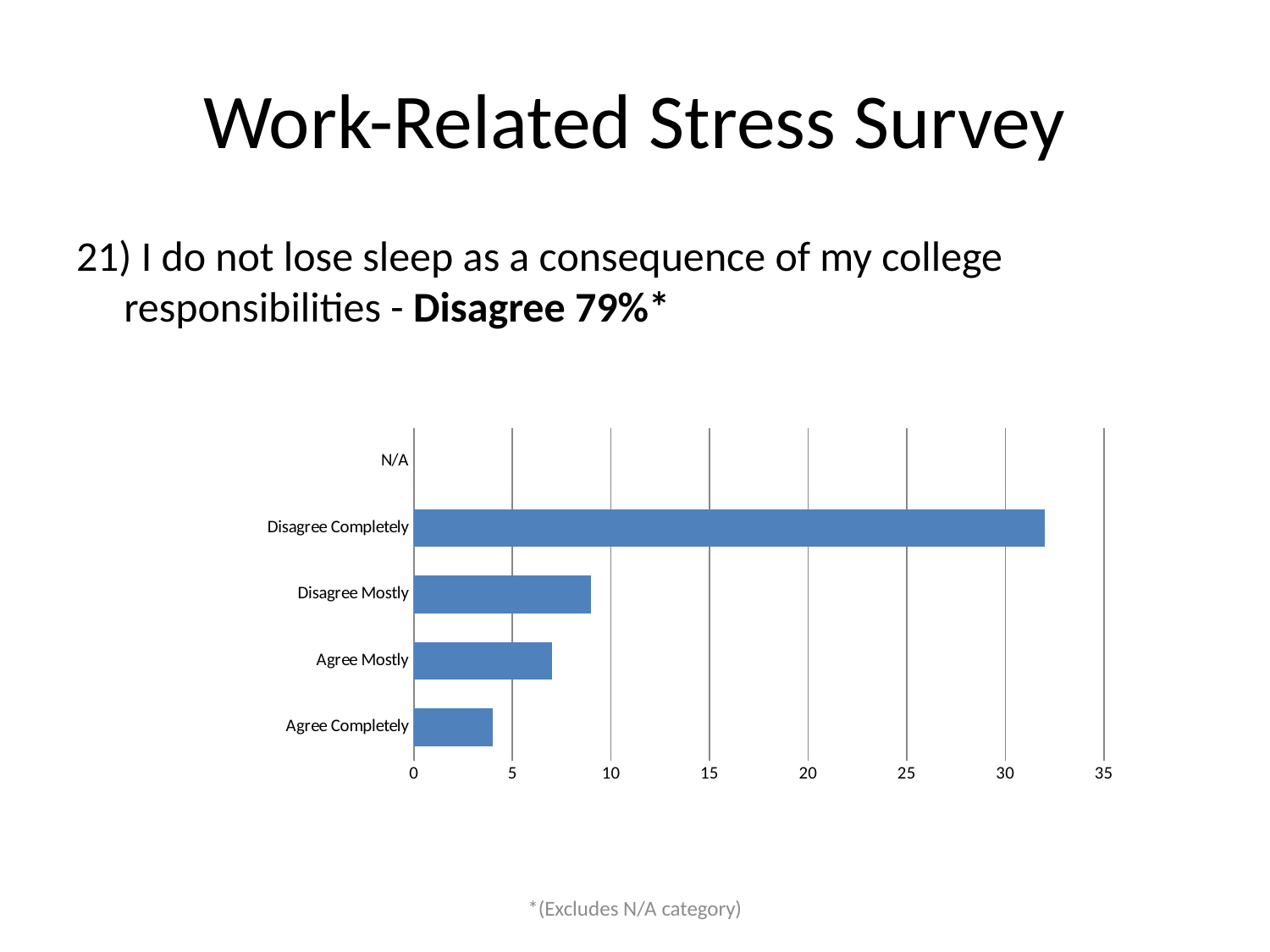
Which is larger, the value for Disagree Mostly or the value for Agree Mostly? Disagree Mostly Is the value for Disagree Mostly greater or less than 10? less Is the value for Agree Mostly greater or less than 5? greater What kind of chart is shown on the slide? bar chart Is the value for Disagree Completely greater or less than 30? greater Which is larger, the value for Agree Completely or the value for Disagree Completely? Disagree Completely Which category with a visible bar has the lowest value in the chart? Agree Completely Which category has the highest value in the chart? Disagree Completely What percentage is given on the slide for Disagree for question 21? 79% How many categories are shown on the chart's vertical axis? 5 What is the maximum value shown on the chart's horizontal axis? 35